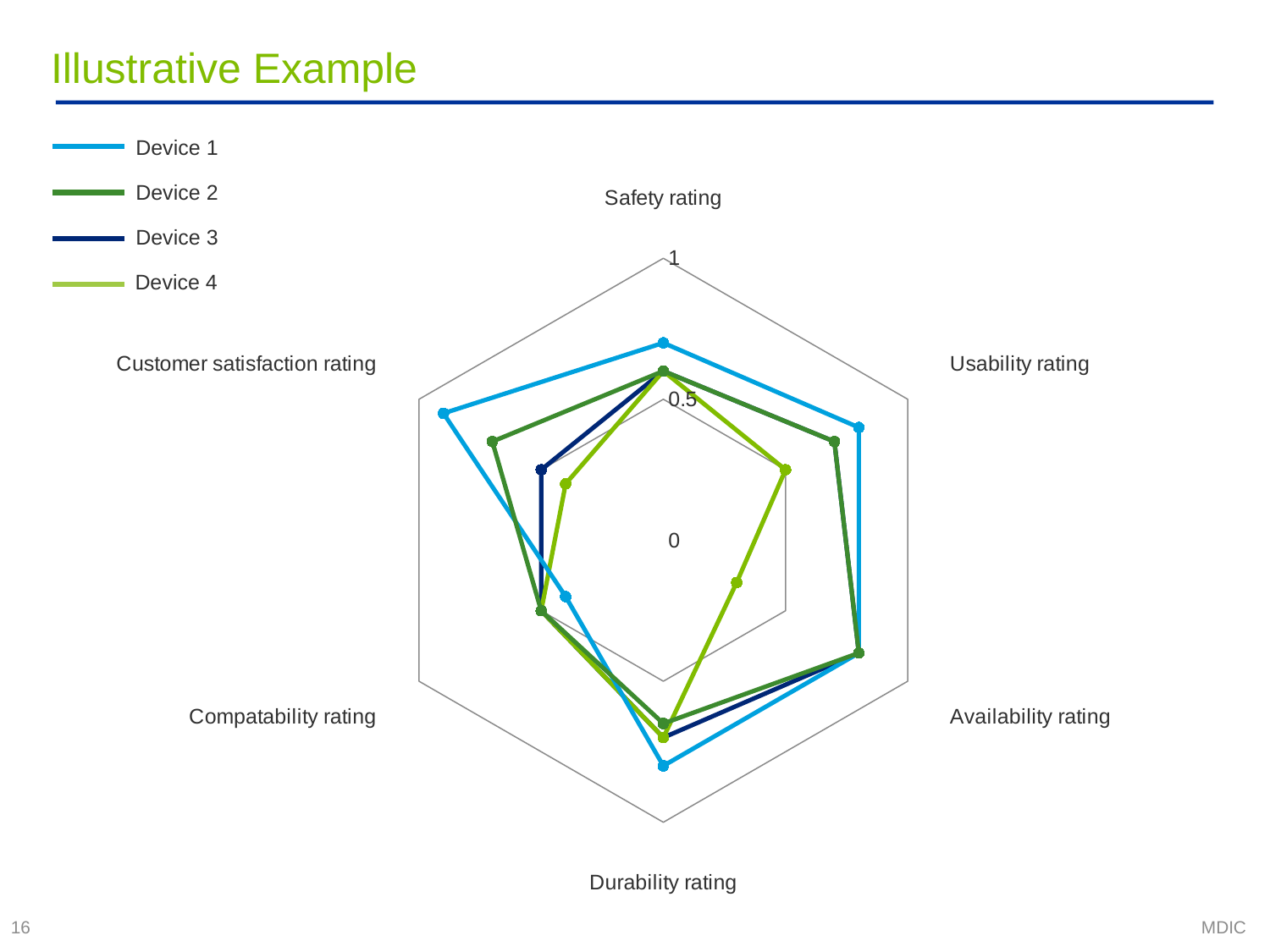
Which device has the lowest Compatability rating? Device 1 Is the Availability rating for Device 4 greater or less than 0.5? less Is the Customer satisfaction rating for Device 1 greater or less than 0.5? greater How many series does the legend list? 4 Which device has the highest Safety rating? Device 1 What is the title of the slide containing the radar chart? Illustrative Example How many rating categories are plotted on the radar chart? 6 Which device has the highest Customer satisfaction rating? Device 1 Which device has the lowest Availability rating? Device 4 Which is larger, the Usability rating for Device 1 or for Device 4? Device 1 What kind of chart is shown on the slide? Radar chart Which is larger, the Customer satisfaction rating for Device 2 or for Device 4? Device 2